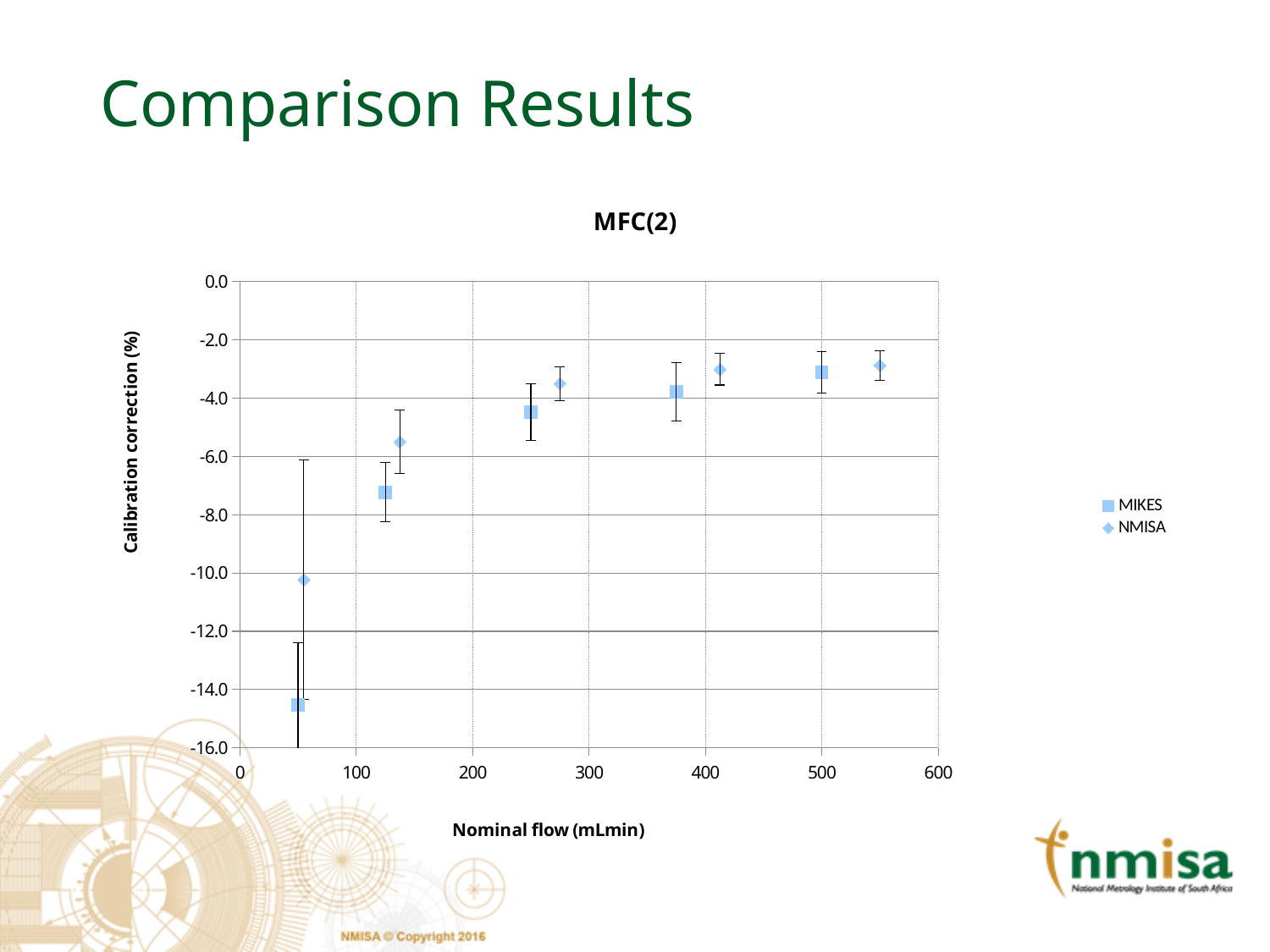
How many data points are plotted for the NMISA series? 5 At the lowest nominal flow, which series has the larger calibration correction value, MIKES or NMISA? NMISA Is the lowest NMISA value greater or less than -12.0? greater Is the lowest MIKES value greater or less than -12.0? less What kind of chart is shown on the slide? scatter chart How many data points are plotted for the MIKES series? 5 How many series does the legend list? 2 Which series has the lowest plotted calibration correction value? MIKES Do the calibration correction values rise or fall as nominal flow increases? rise What is the label of the x axis? Nominal flow (mLmin) What is the title of the chart? MFC(2) Is the NMISA value at the highest nominal flow greater or less than -4.0? greater